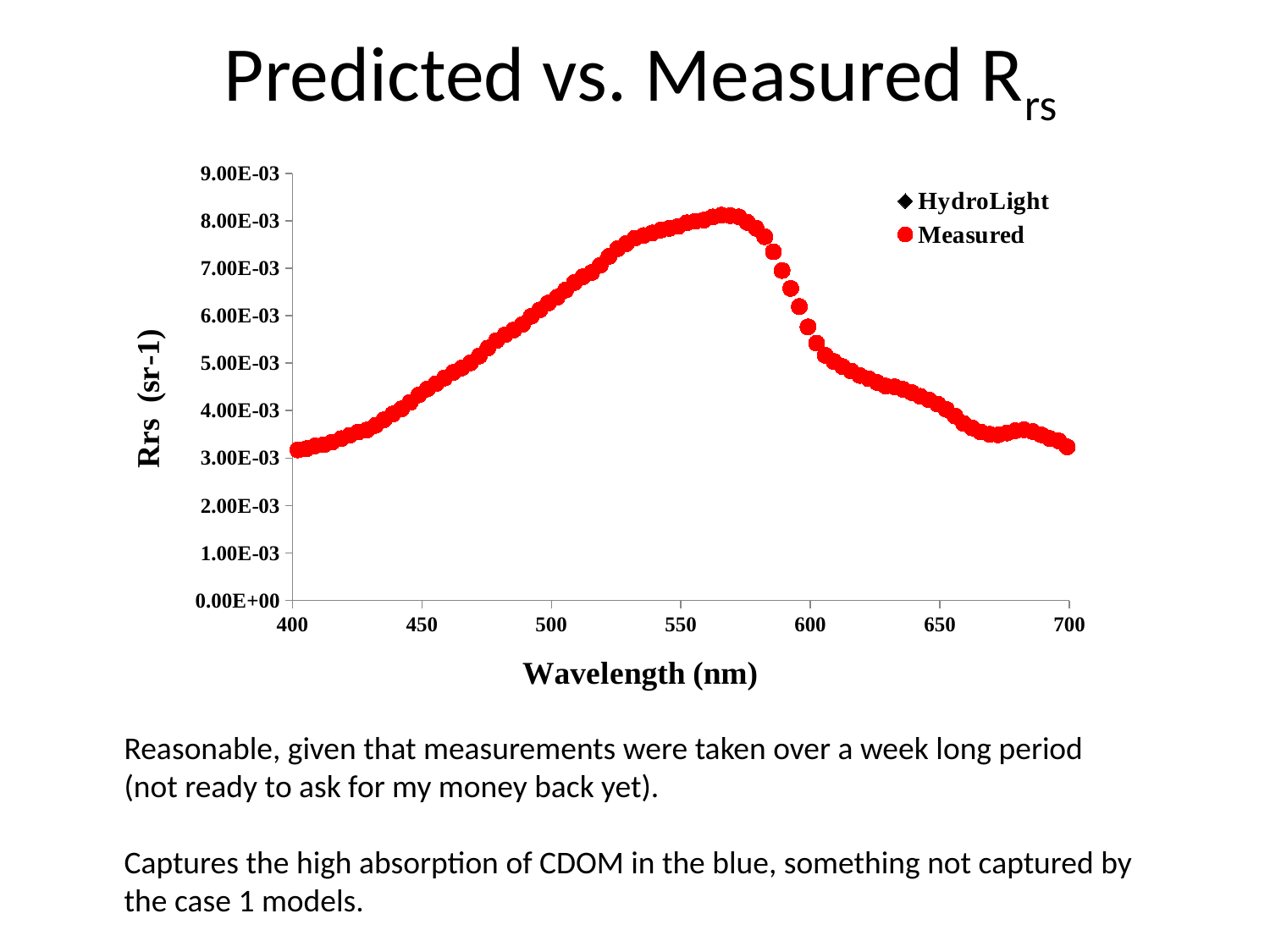
Which is larger, the Measured value at 550 nm or at 650 nm? 550 nm What kind of chart is shown on the slide? Scatter plot Is the Measured value at 550 nm greater or less than 7.00E-03? greater Is the Measured value at 650 nm greater or less than 5.00E-03? less Is the Measured value at 700 nm greater or less than 4.00E-03? less What is the label of the x axis? Wavelength (nm) How many series does the legend list? 2 Do the Measured values rise or fall as wavelength increases from 400 nm to 550 nm? rise Do the Measured values rise or fall overall as wavelength increases from 600 nm to 700 nm? fall What are the two series named in the legend? HydroLight and Measured